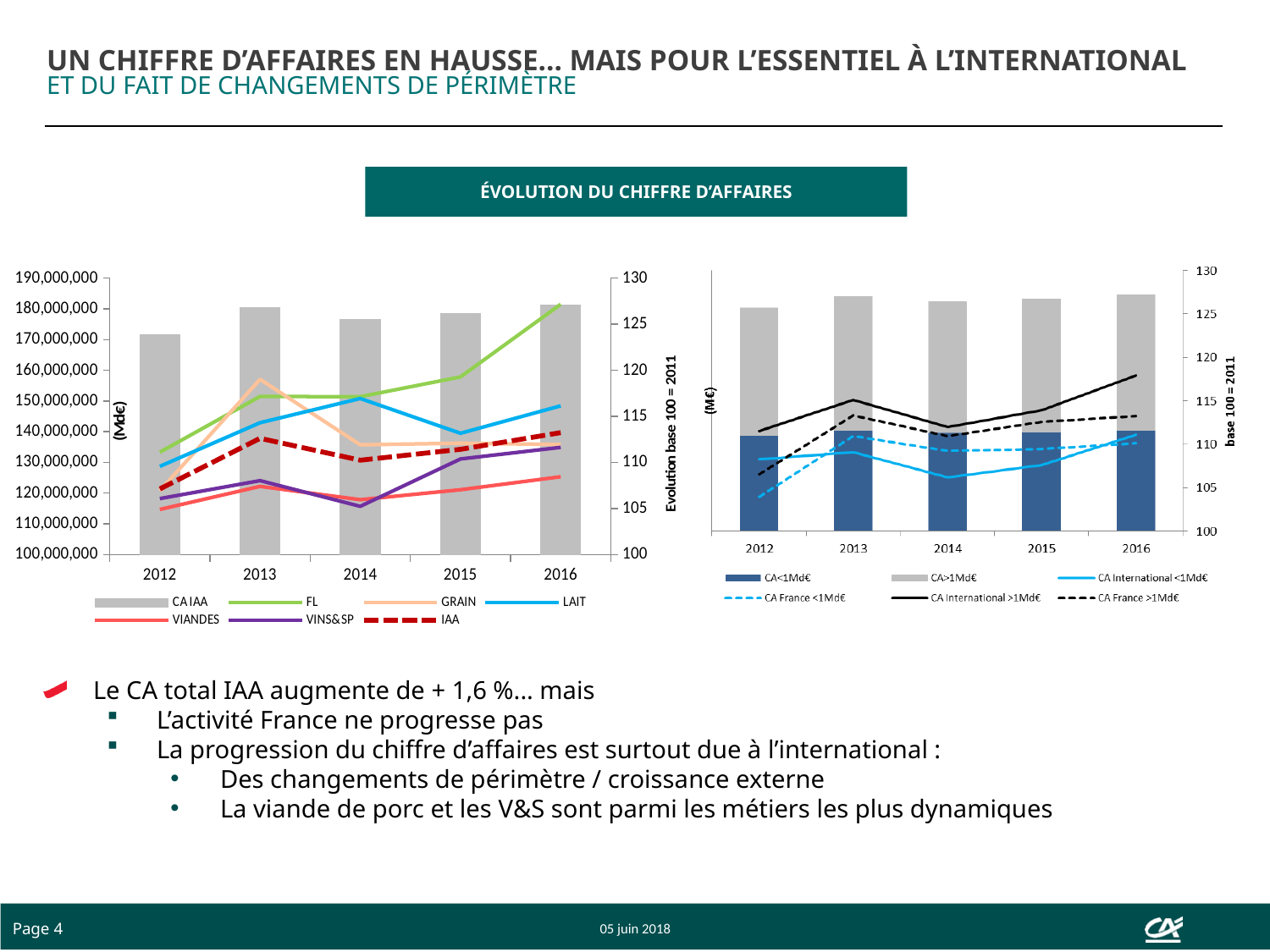
On the left chart, how many years are shown on the x axis? 5 On the left chart, does the FL line rise or fall from 2012 to 2016? rise On the right chart, which line series has the highest value in 2016? CA International >1Md€ On the left chart, which line series has the lowest value in 2012? VIANDES What kind of chart is the left chart? Combined bar and line chart On the left chart, is the CA IAA bar for 2012 greater or less than 180,000,000? less On the left chart, is the FL value for 2016 greater or less than 125? greater On the left chart, in which year is the CA IAA bar the lowest? 2012 On the right chart, is the CA International <1Md€ value for 2014 greater or less than 110? less On the left chart, which line series has the highest value in 2016? FL On the left chart, how many series does the legend list? 7 On the right chart, how many series does the legend list? 6